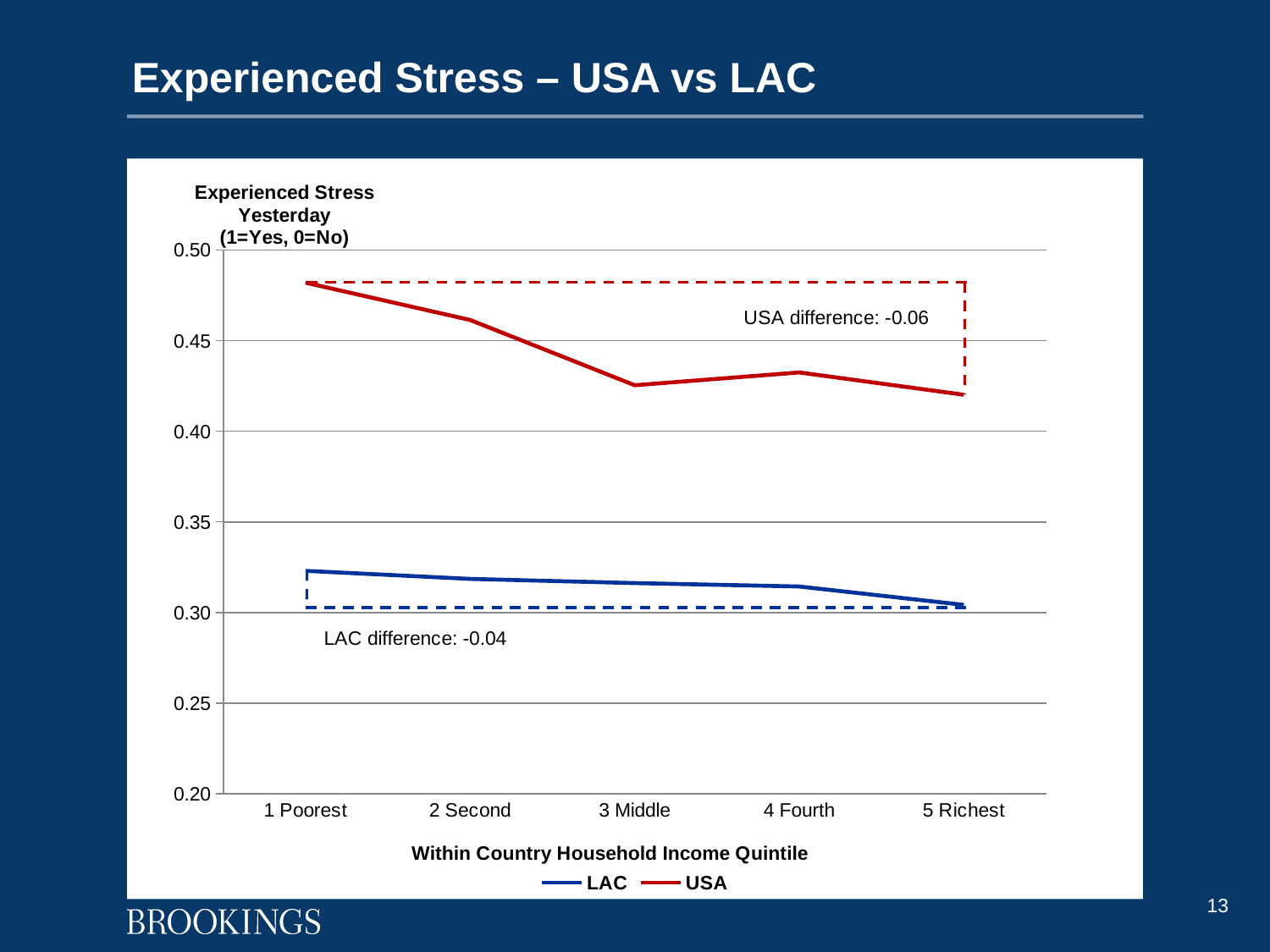
What USA difference is annotated on the chart? -0.06 Is the USA value for 5 Richest greater or less than 0.40? greater Which series has the higher value at 3 Middle, LAC or USA? USA For the LAC series, which income quintile has the highest value? 1 Poorest What kind of chart is shown on the slide? line chart Is the LAC value for 5 Richest greater or less than 0.35? less How many series does the legend list? 2 Is the LAC value for 1 Poorest greater or less than 0.30? greater For the LAC series, which income quintile has the lowest value? 5 Richest Do the USA values generally rise or fall from 1 Poorest to 5 Richest? fall How many income quintile categories are shown on the x axis? 5